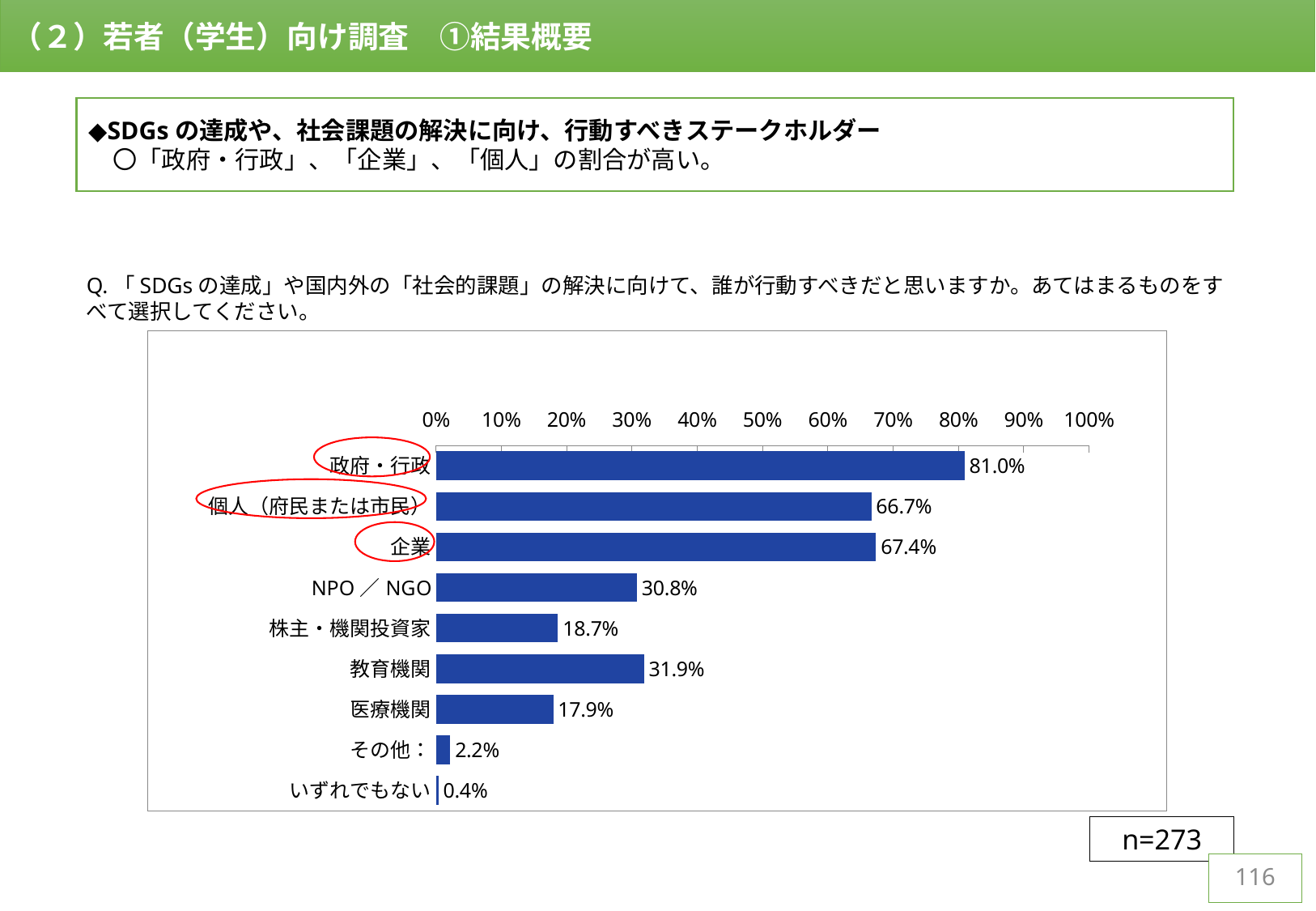
What is the value for 企業? 67.4% What is the value for 医療機関? 17.9% What is the value for 政府・行政? 81.0% What is the value for NPO／NGO? 30.8% What is the sample size (n) shown below the chart? n=273 Is the value for 株主・機関投資家 greater or less than 20%? less Which is larger, the value for 教育機関 or the value for NPO／NGO? 教育機関 Which category has the highest value? 政府・行政 What is the difference between the values for 政府・行政 and 企業? 13.6% Which category has the lowest value? いずれでもない What kind of chart is shown on the slide? bar chart How many categories are shown in the chart? 9